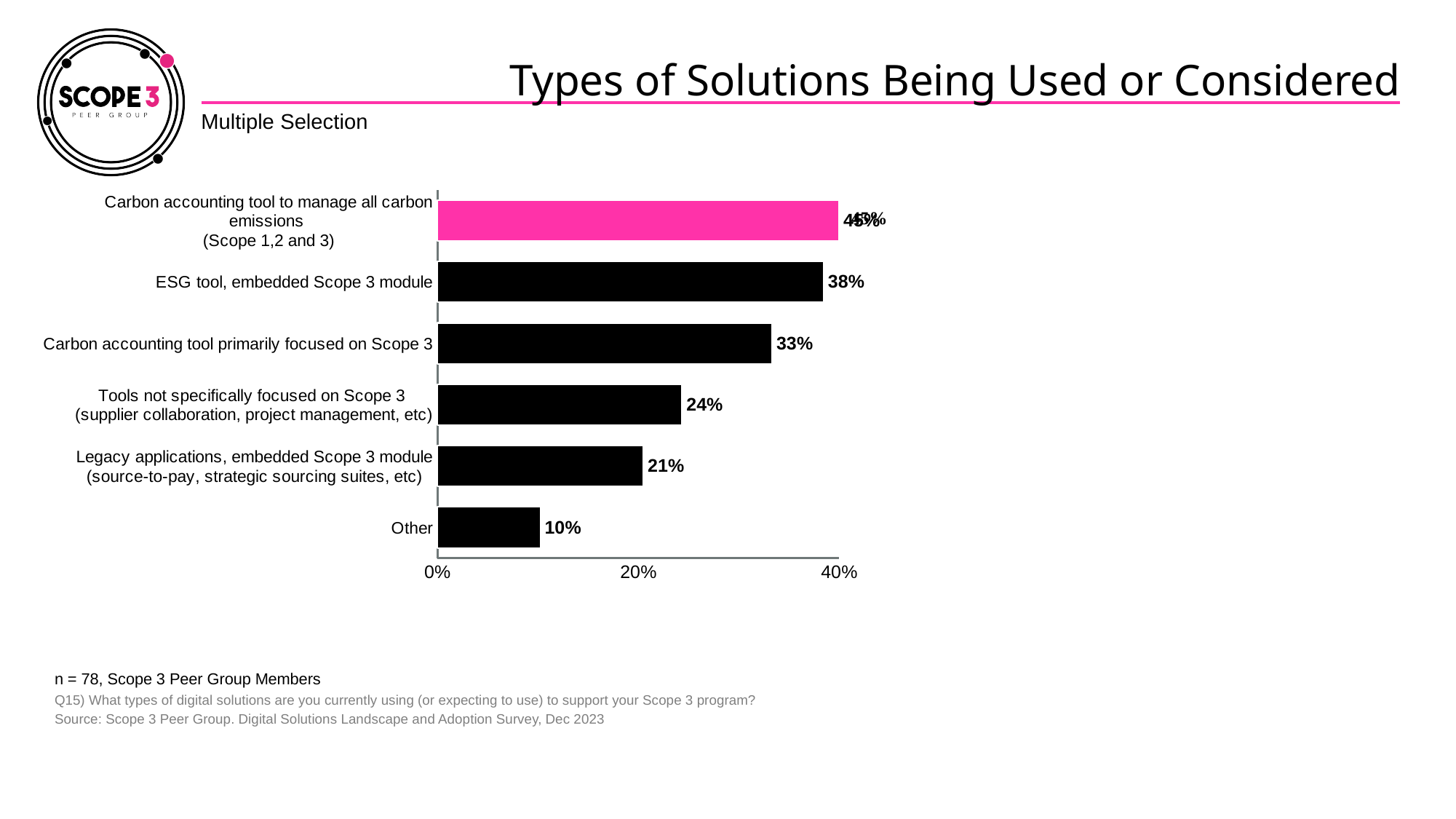
What is the value for "Carbon accounting tool primarily focused on Scope 3"? 33% What is the difference between "Tools not specifically focused on Scope 3" and "Other"? 14% What is the value for "Tools not specifically focused on Scope 3"? 24% What is the value for "Other"? 10% What is the value for "Legacy applications, embedded Scope 3 module"? 21% How many categories are shown in the chart? 6 Which category has the lowest value? Other What is the value for "ESG tool, embedded Scope 3 module"? 38% What type of chart is shown on the slide? Bar chart Is the value for "Carbon accounting tool primarily focused on Scope 3" greater or less than 20%? greater What is the difference between "ESG tool, embedded Scope 3 module" and "Carbon accounting tool primarily focused on Scope 3"? 5% Which is larger: "Legacy applications, embedded Scope 3 module" or "Tools not specifically focused on Scope 3"? Tools not specifically focused on Scope 3